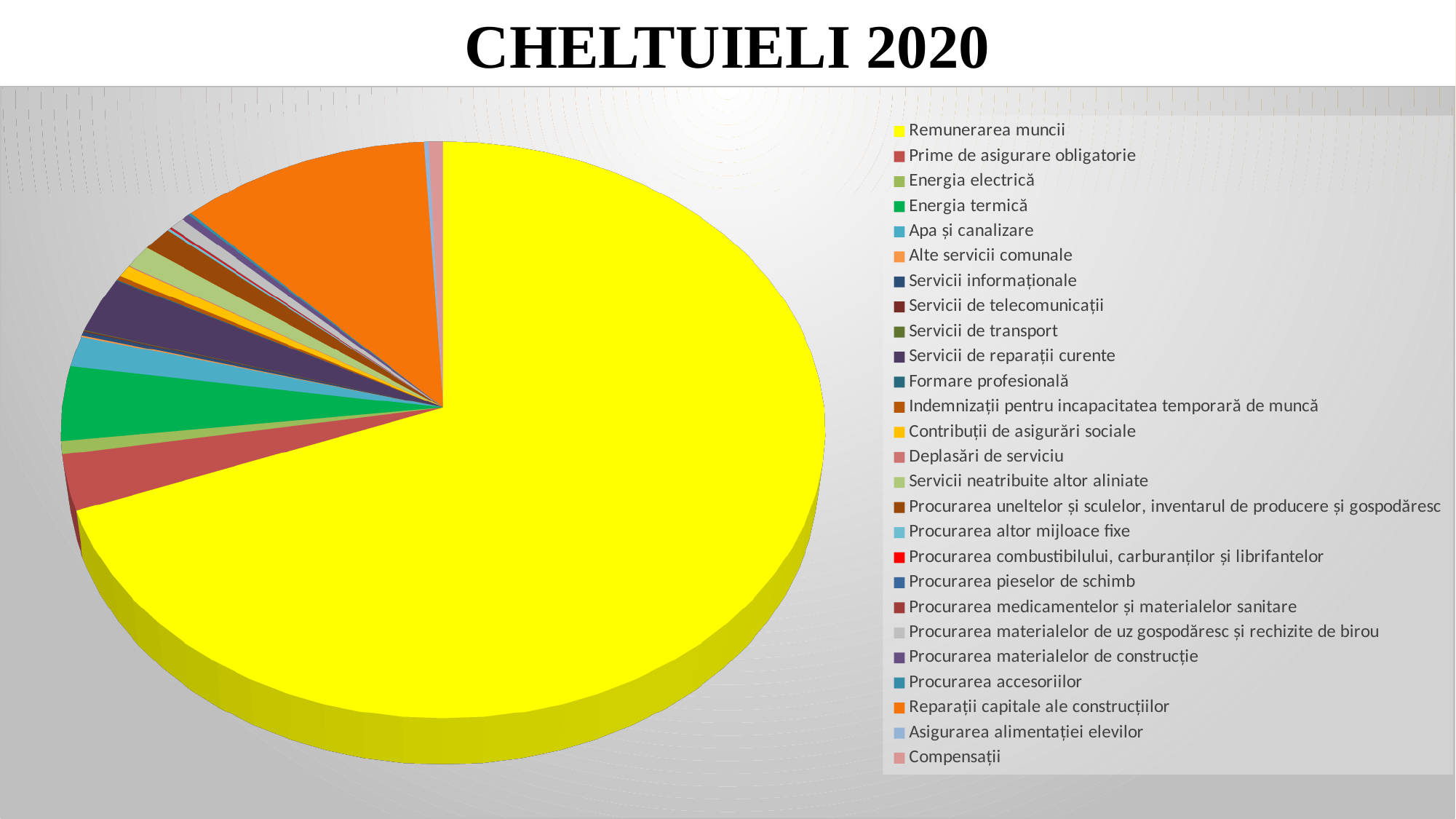
What is the title of the slide? CHELTUIELI 2020 Which slice is larger, Remunerarea muncii or Reparații capitale ale construcțiilor? Remunerarea muncii Which slice is larger, Energia termică or Energia electrică? Energia termică Which slice is larger, Prime de asigurare obligatorie or Apa și canalizare? Prime de asigurare obligatorie What kind of chart is shown on the slide? pie chart Which category has the largest slice of the pie? Remunerarea muncii What colour is the slice for Remunerarea muncii? yellow How many categories does the legend list? 26